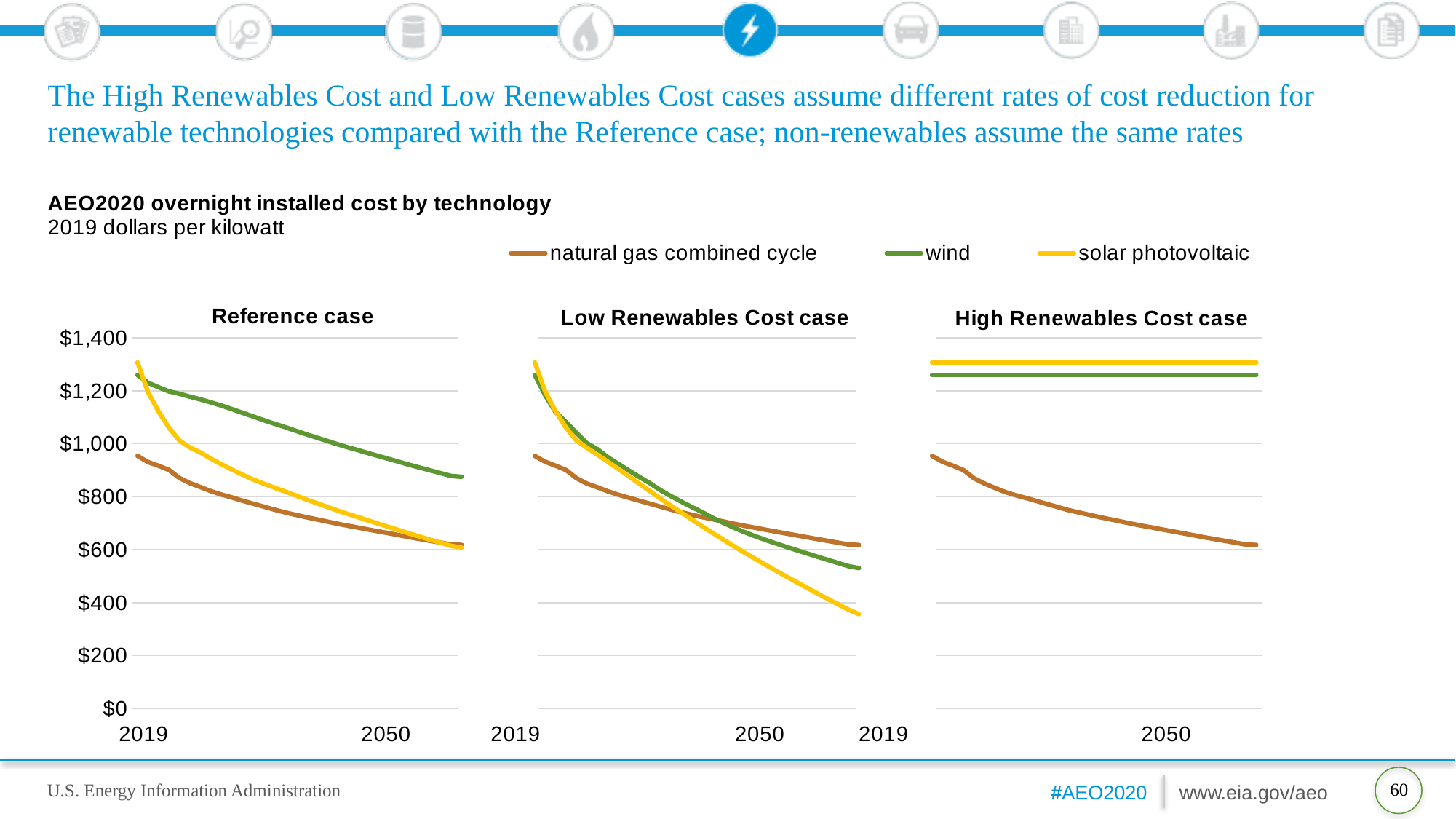
In the Reference case chart, is the 2019 value for solar photovoltaic greater or less than $1,200? greater In the High Renewables Cost case chart, is the value for wind greater or less than $1,200? greater How many series does the legend list? 3 What kind of chart is used for the Reference case panel? line chart In the Reference case chart, is the 2019 value for natural gas combined cycle greater or less than $1,000? less In the High Renewables Cost case chart, does the solar photovoltaic line rise, fall, or stay flat over time? stay flat In the Low Renewables Cost case chart, which is higher at the end of the projection, natural gas combined cycle or solar photovoltaic? natural gas combined cycle In the Reference case chart, does the wind line rise or fall from 2019 to 2050? fall In the Low Renewables Cost case chart, does the natural gas combined cycle line rise or fall from 2019 to 2050? fall In the High Renewables Cost case chart, which series has the highest values? solar photovoltaic What unit is given for the values in the charts? 2019 dollars per kilowatt